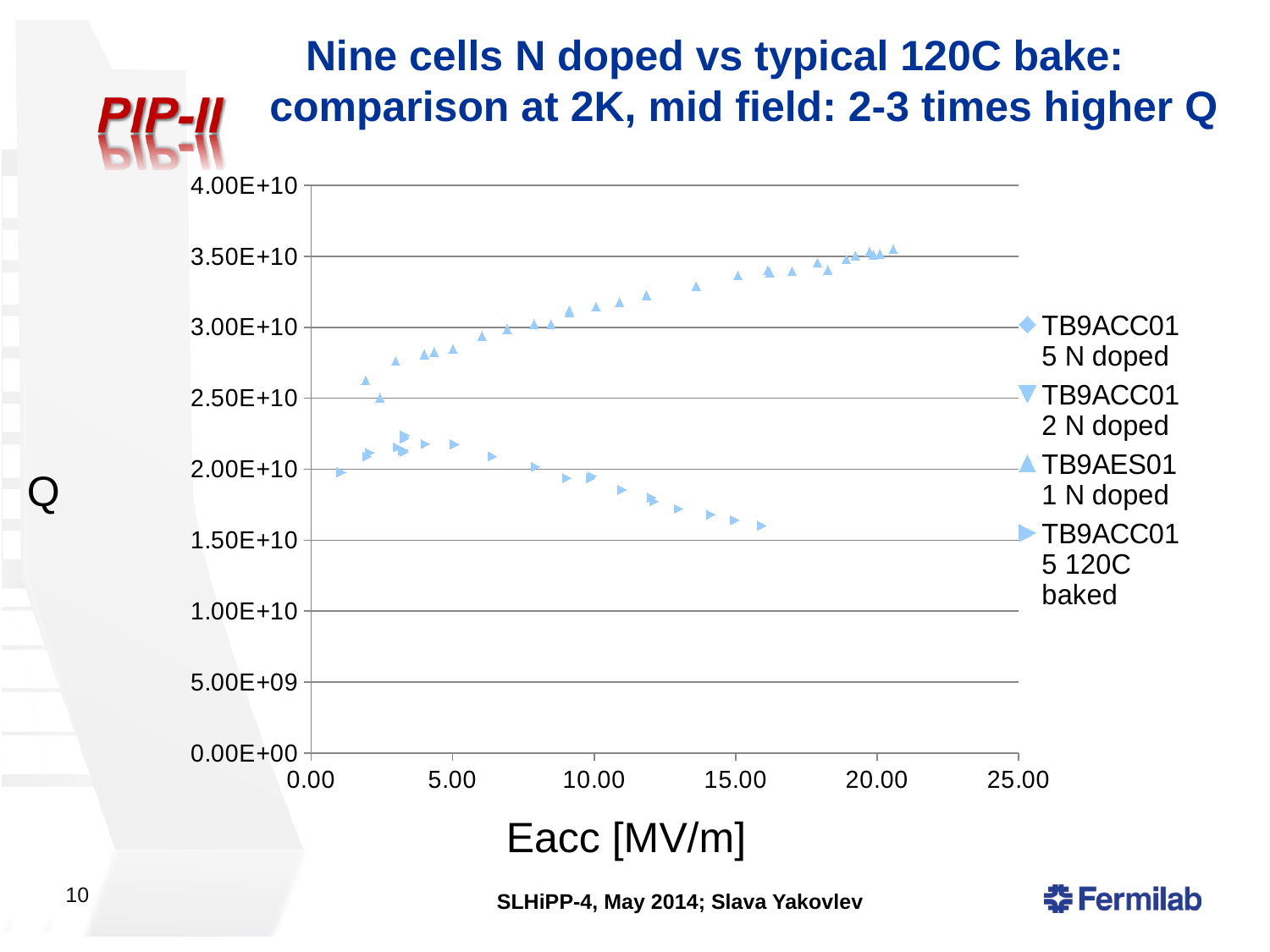
Is the value for TB9ACC015 120C baked at 3 MV/m greater or less than 2.50E+10? less What is the title of the x axis? Eacc [MV/m] How many series does the legend list? 4 Is the value for TB9ACC015 120C baked at 15 MV/m greater or less than 2.00E+10? less Is the value for TB9AES011 N doped at 20 MV/m greater or less than 3.00E+10? greater What kind of chart is shown on the slide? scatter chart Beyond about 5 MV/m, do the values for TB9ACC015 120C baked rise or fall as Eacc increases? fall Do the values for TB9AES011 N doped rise or fall as Eacc increases? rise What quantity is plotted on the y axis? Q